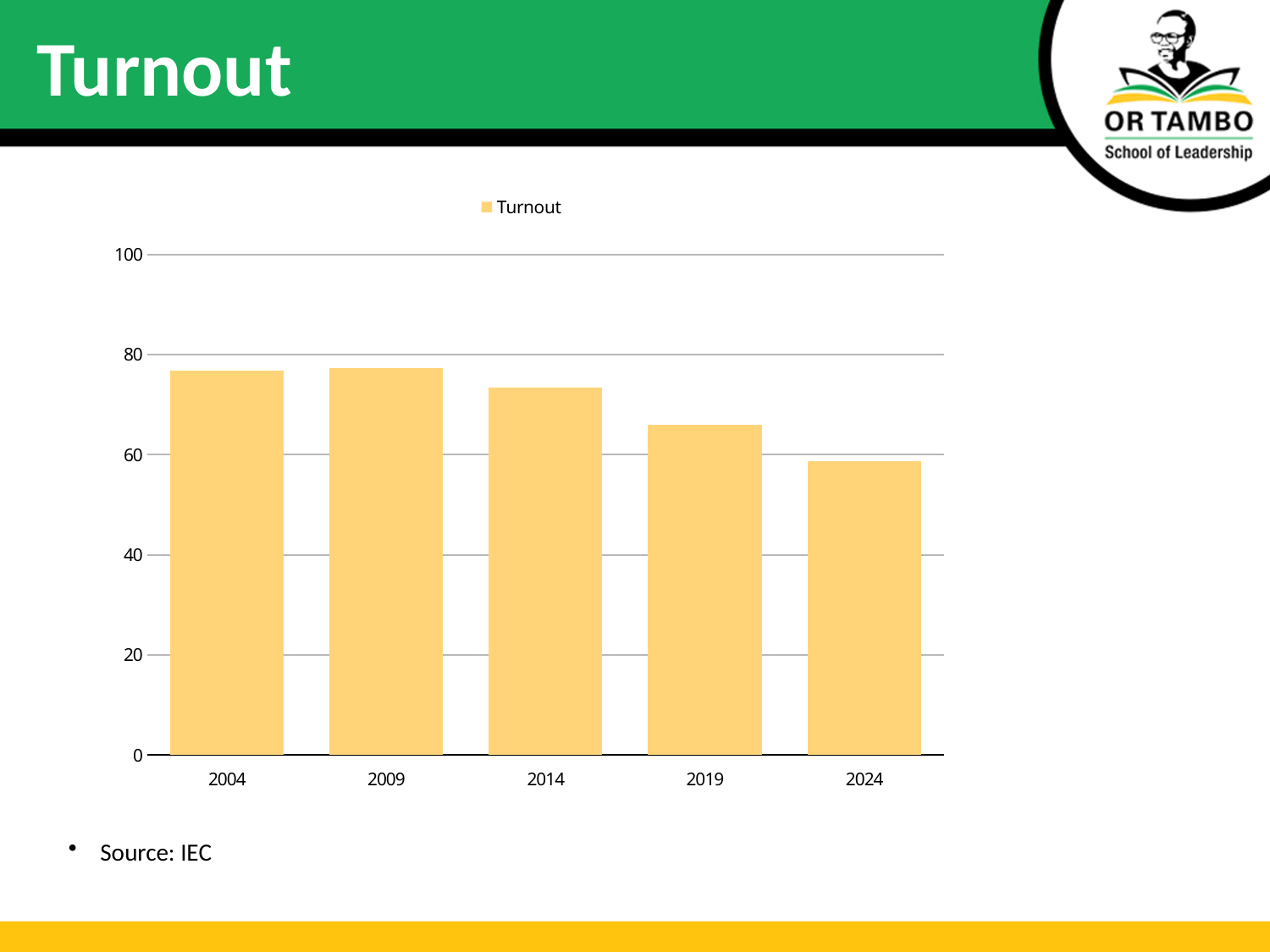
Is the turnout value for 2014 greater or less than 60? greater Is the turnout value for 2024 greater or less than 60? less What is the name of the series shown in the chart's legend? Turnout Which year has the larger turnout, 2014 or 2024? 2014 Which year has the lowest turnout in the chart? 2024 How many years are shown on the x axis of the chart? 5 Is the turnout value for 2004 greater or less than 80? less Do the turnout values generally rise or fall from 2009 to 2024? fall Which year has the larger turnout, 2019 or 2024? 2019 What kind of chart is shown on the slide? bar chart How many series does the chart's legend list? 1